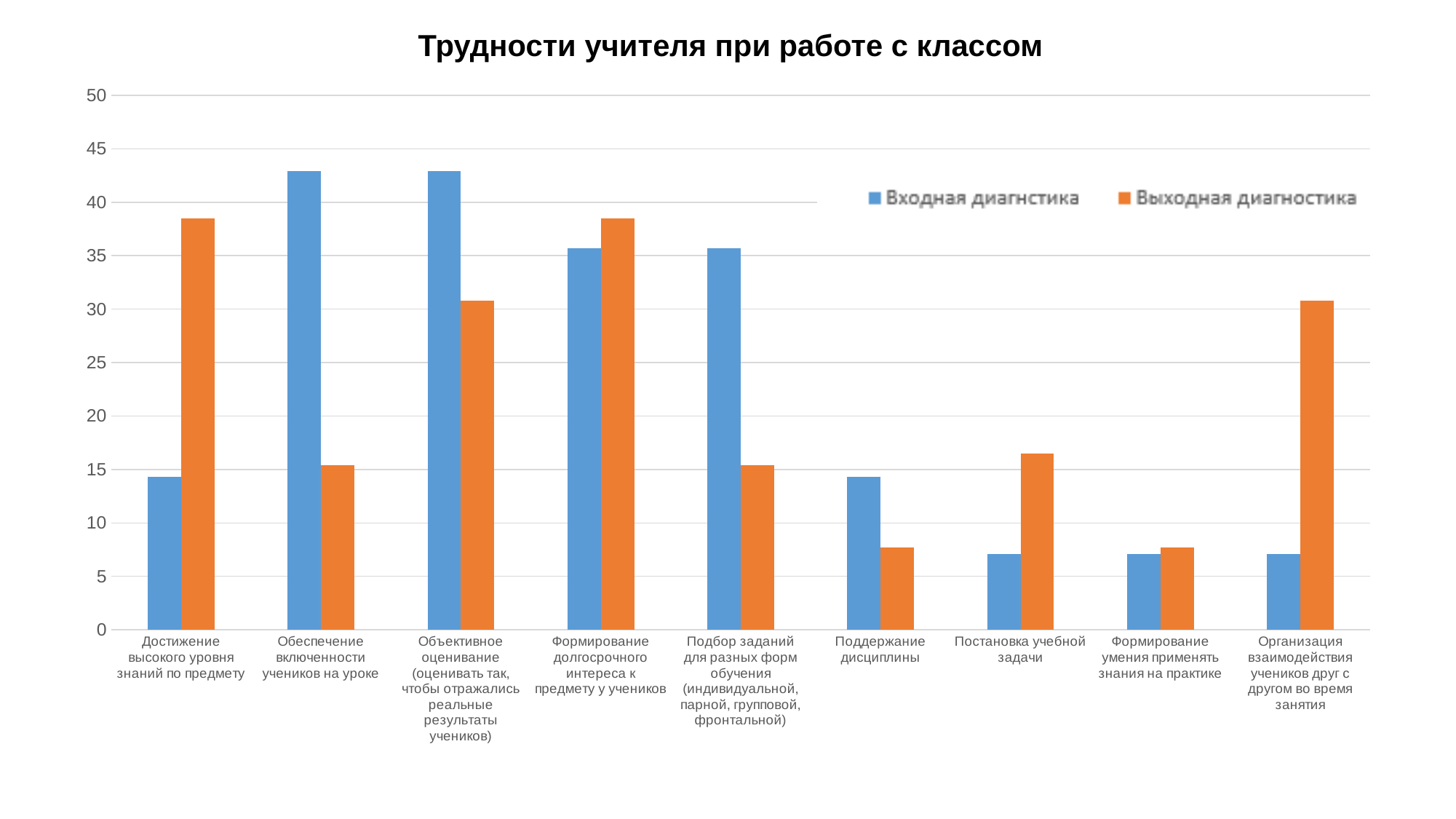
Is the value of Выходная диагностика for 'Организация взаимодействия учеников друг с другом во время занятия' greater or less than 25? greater Which series is shown in orange? Выходная диагностика How many categories are shown on the x axis of the chart? 9 How many series does the legend list? 2 For 'Достижение высокого уровня знаний по предмету', which series has the larger value, Входная диагнстика or Выходная диагностика? Выходная диагностика Is the value of Выходная диагностика for 'Достижение высокого уровня знаний по предмету' greater or less than 35? greater Is the value of Входная диагнстика for 'Обеспечение включенности учеников на уроке' greater or less than 40? greater For 'Обеспечение включенности учеников на уроке', which series has the larger value, Входная диагнстика or Выходная диагностика? Входная диагнстика For 'Поддержание дисциплины', which series has the larger value, Входная диагнстика or Выходная диагностика? Входная диагнстика What kind of chart is shown on the slide? bar chart What is the title of the chart? Трудности учителя при работе с классом